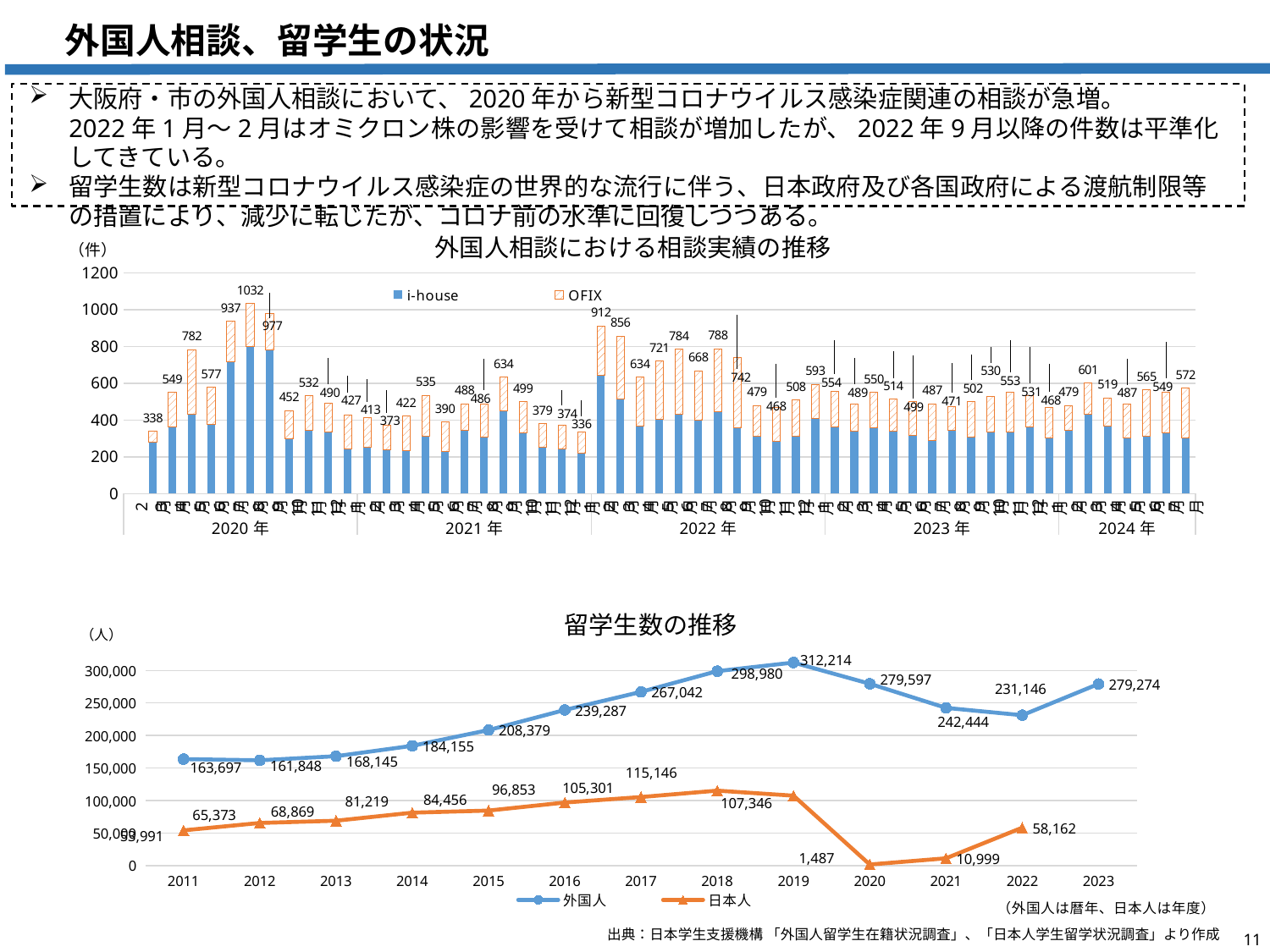
In the top chart '外国人相談における相談実績の推移', what is the highest monthly total shown? 1032 In the bottom chart '留学生数の推移', what is the value for 外国人 in 2019? 312,214 In the bottom chart '留学生数の推移', how many series does the legend list? 2 In the bottom chart '留学生数の推移', which year has the lowest value for 日本人? 2020 In the bottom chart '留学生数の推移', what is the value for 日本人 in 2020? 1,487 In the top chart '外国人相談における相談実績の推移', what are the two series listed in the legend? i-house and OFIX In the bottom chart '留学生数の推移', which is larger: the 日本人 value for 2018 or for 2019? 2018 In the bottom chart '留学生数の推移', what is the value for 外国人 in 2023? 279,274 In the bottom chart '留学生数の推移', what kind of chart is it? Line chart In the top chart '外国人相談における相談実績の推移', what is the lowest monthly total shown? 336 In the bottom chart '留学生数の推移', which year has the highest value for 外国人? 2019 In the bottom chart '留学生数の推移', what is the difference between the 外国人 values for 2019 and 2020? 32,617